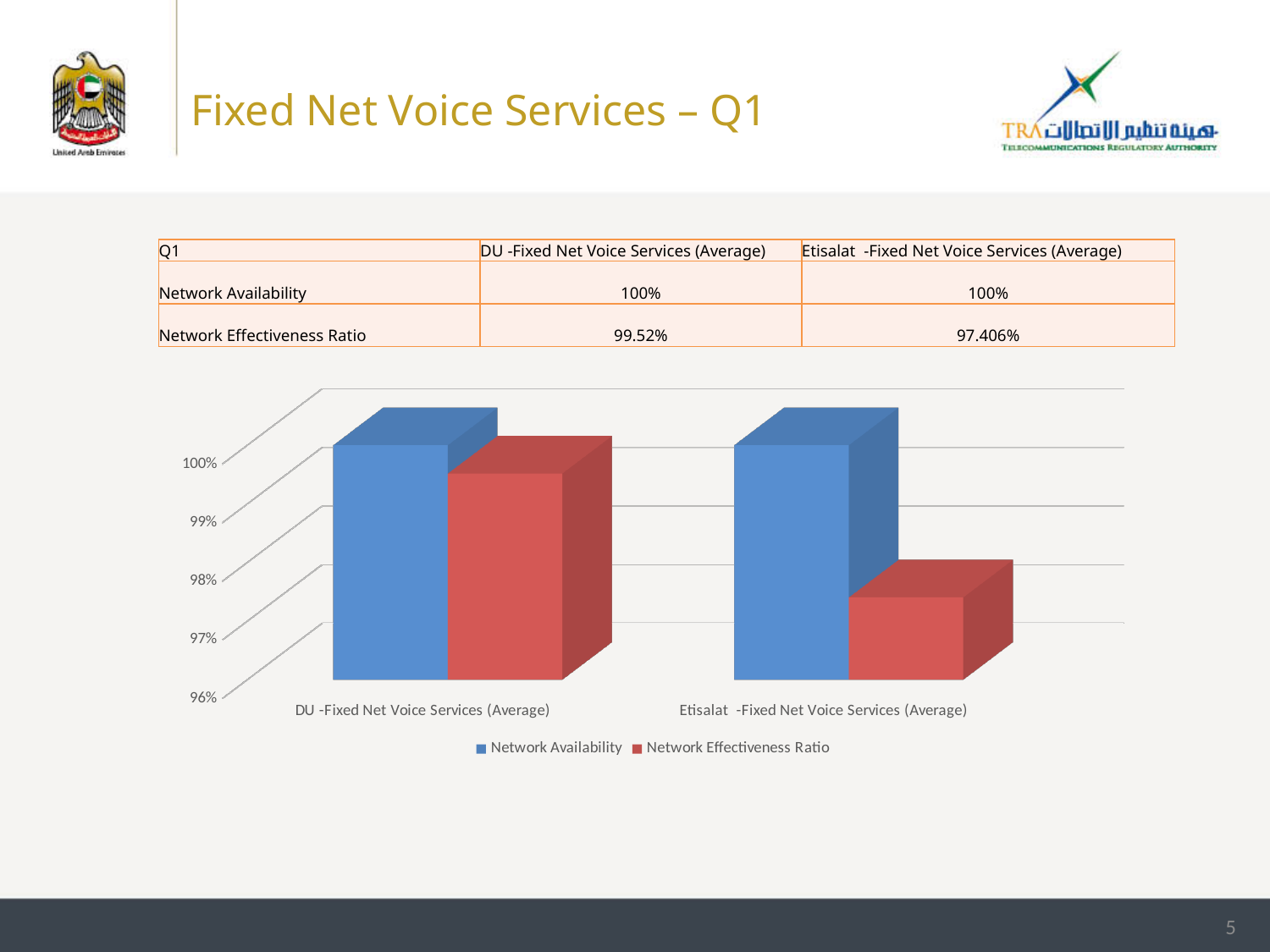
Is the Network Effectiveness Ratio for Etisalat greater or less than 98%? less What type of chart is shown on the slide? bar chart Which operator has the higher Network Effectiveness Ratio, DU or Etisalat? DU What is the difference between the Network Effectiveness Ratio of DU and that of Etisalat? 2.114% Which category has the lowest Network Effectiveness Ratio? Etisalat - Fixed Net Voice Services (Average) What is the Network Availability value for Etisalat - Fixed Net Voice Services (Average)? 100% What is the Network Availability value for DU - Fixed Net Voice Services (Average)? 100% What is the Network Effectiveness Ratio for DU - Fixed Net Voice Services (Average)? 99.52% What is the Network Effectiveness Ratio for Etisalat - Fixed Net Voice Services (Average)? 97.406% How many categories are shown on the x axis of the chart? 2 How many series does the chart legend list? 2 Which colour represents the Network Effectiveness Ratio series in the chart? red